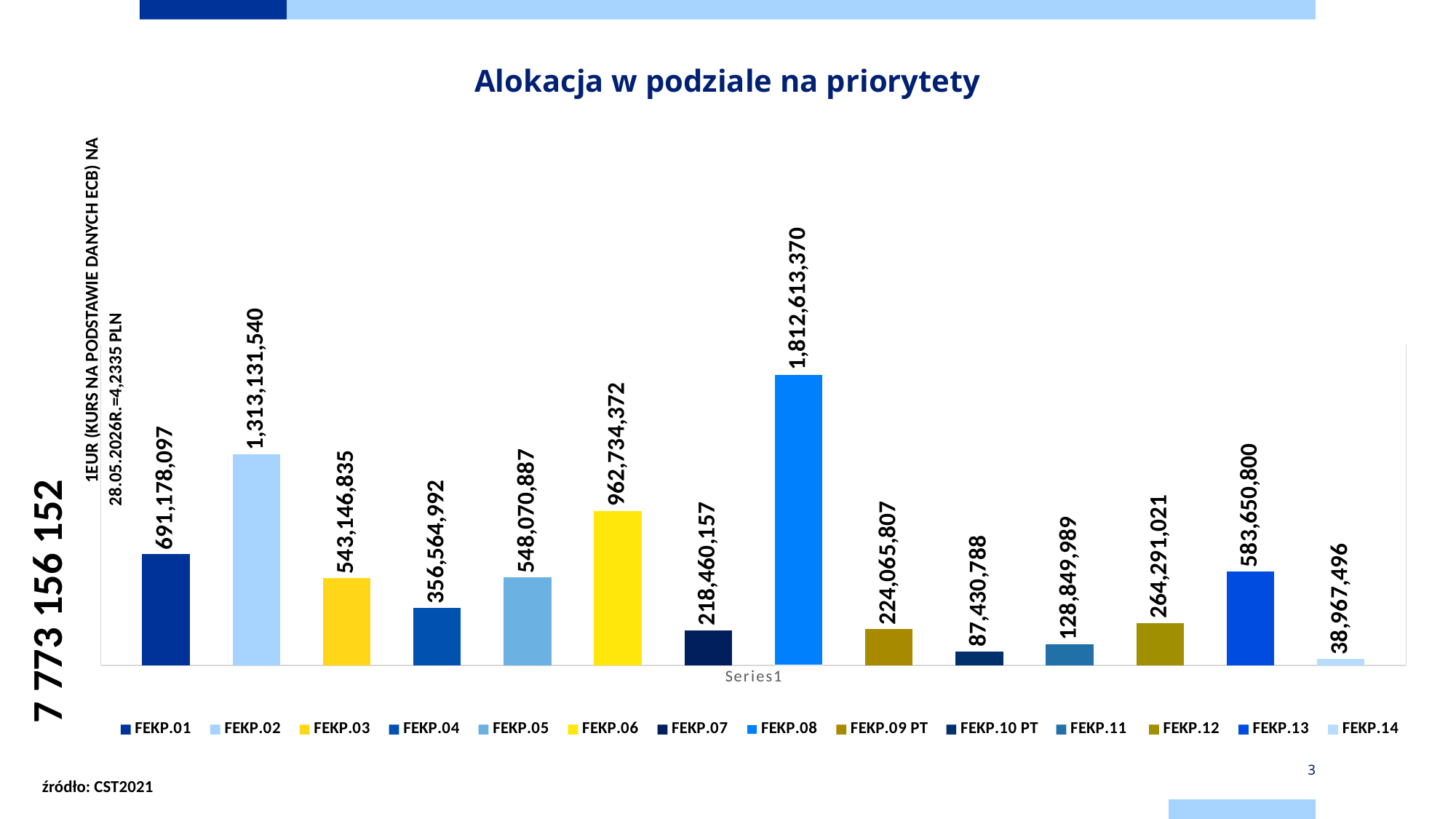
How many bars are plotted in the chart? 14 What is the value for FEKP.14? 38,967,496 What kind of chart is shown on the slide? bar chart Which category has the highest value? FEKP.08 Which category has the lowest value? FEKP.14 What is the value for FEKP.08? 1,812,613,370 What is the difference between the values for FEKP.01 and FEKP.13? 107,527,297 What is the title of the chart? Alokacja w podziale na priorytety Which is larger, the value for FEKP.06 or the value for FEKP.01? FEKP.06 What is the value for FEKP.10 PT? 87,430,788 What is the value for FEKP.02? 1,313,131,540 What is the difference between the values for FEKP.08 and FEKP.02? 499,481,830